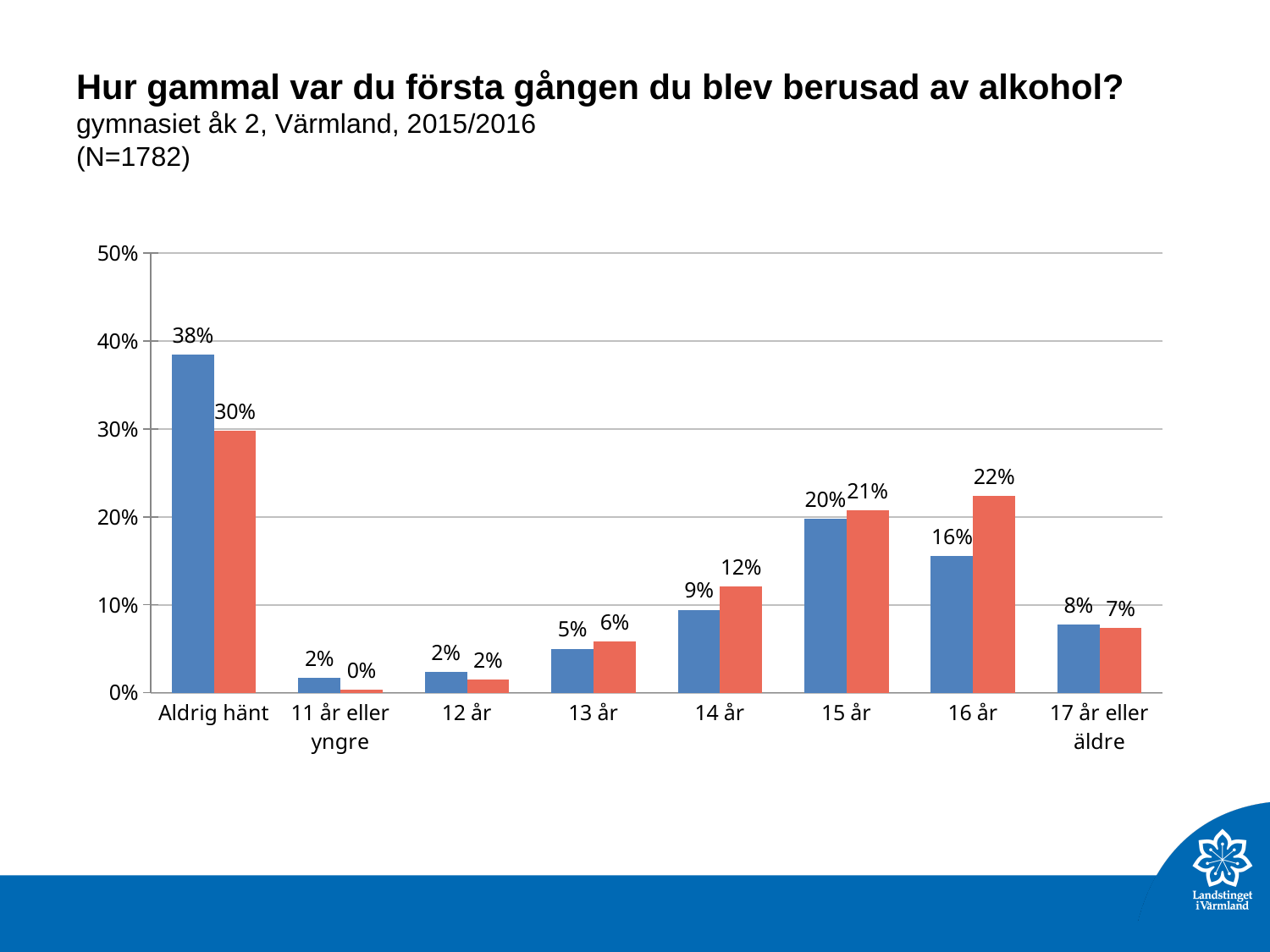
What is the value of the red bar for "16 år"? 22% What is the value of the blue bar for "14 år"? 9% Which category has the lowest red bar? 11 år eller yngre What kind of chart is shown on the slide? bar chart What is the value of the blue bar for "Aldrig hänt"? 38% What is the difference between the red bars for "16 år" and "14 år"? 10% What is the N value stated in the chart subtitle? N=1782 For "16 år", which bar is larger, the blue or the red? red Which category has the highest blue bar? Aldrig hänt What is the value of the red bar for "11 år eller yngre"? 0% How many categories are shown on the x axis? 8 What is the difference between the blue and red bars for "Aldrig hänt"? 8%